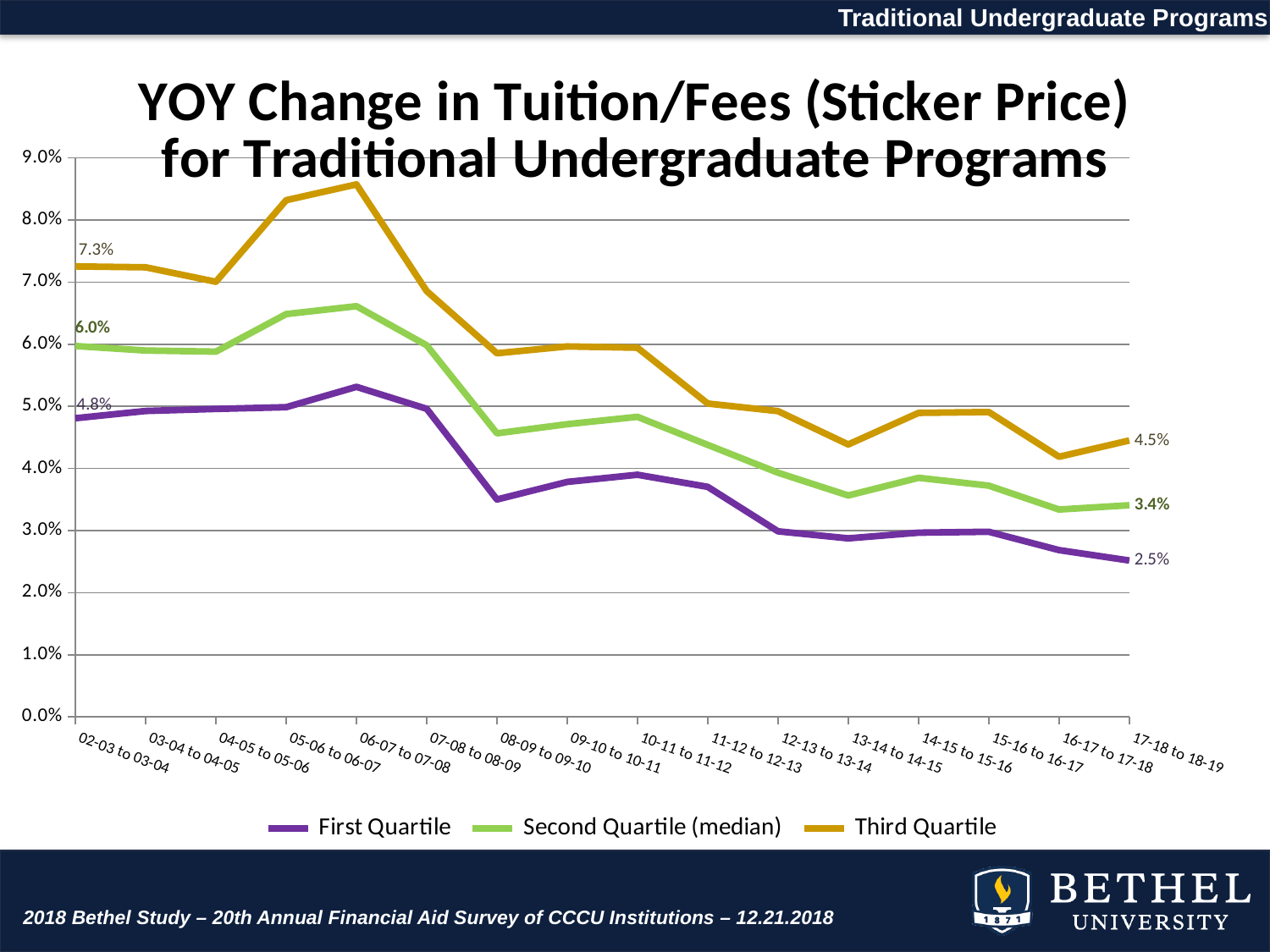
What is the First Quartile value for 02-03 to 03-04? 4.8% What is the First Quartile value for 17-18 to 18-19? 2.5% What is the Third Quartile value for 17-18 to 18-19? 4.5% Is the Third Quartile value for 06-07 to 07-08 greater or less than 8.0%? greater What is the Third Quartile value for 02-03 to 03-04? 7.3% What is the difference between the Third Quartile and First Quartile values for 17-18 to 18-19? 2.0% How many series does the legend list? 3 Overall, do the First Quartile values rise or fall from 02-03 to 03-04 to 17-18 to 18-19? Fall How much did the Second Quartile (median) value fall from 02-03 to 03-04 to 17-18 to 18-19? 2.6% What type of chart is shown on the slide? Line chart What is the Second Quartile (median) value for 02-03 to 03-04? 6.0% Which series has the highest value for 06-07 to 07-08? Third Quartile